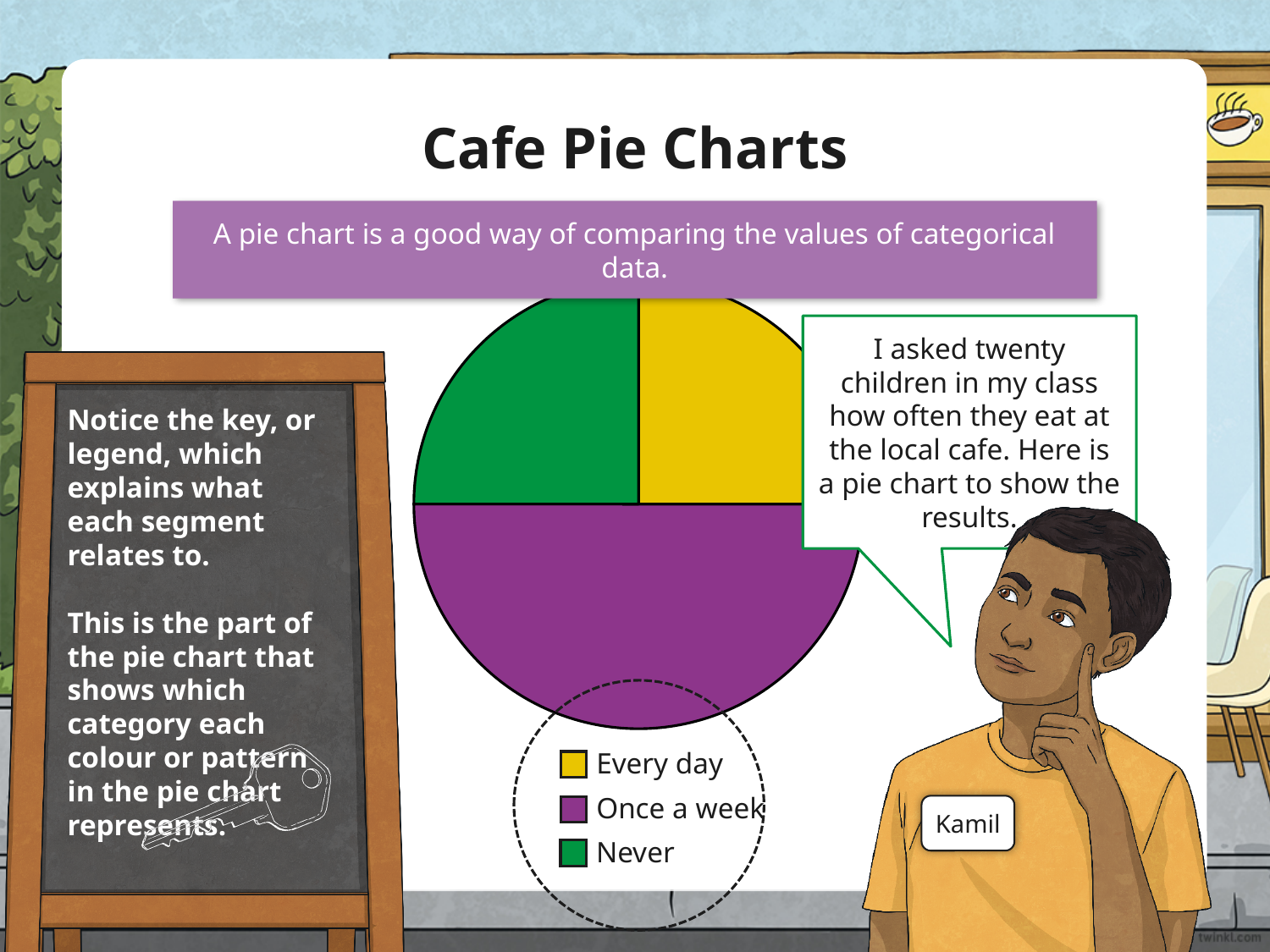
Which slice is larger, Never or Once a week? Once a week Which colour represents the Never category in the pie chart? green Which category is shown in yellow in the pie chart? Every day Which slice is larger, Once a week or Every day? Once a week How many categories does the pie chart show? 3 How many entries does the legend of the pie chart list? 3 What kind of chart is shown on the slide? pie chart Which category has the largest slice of the pie chart? Once a week